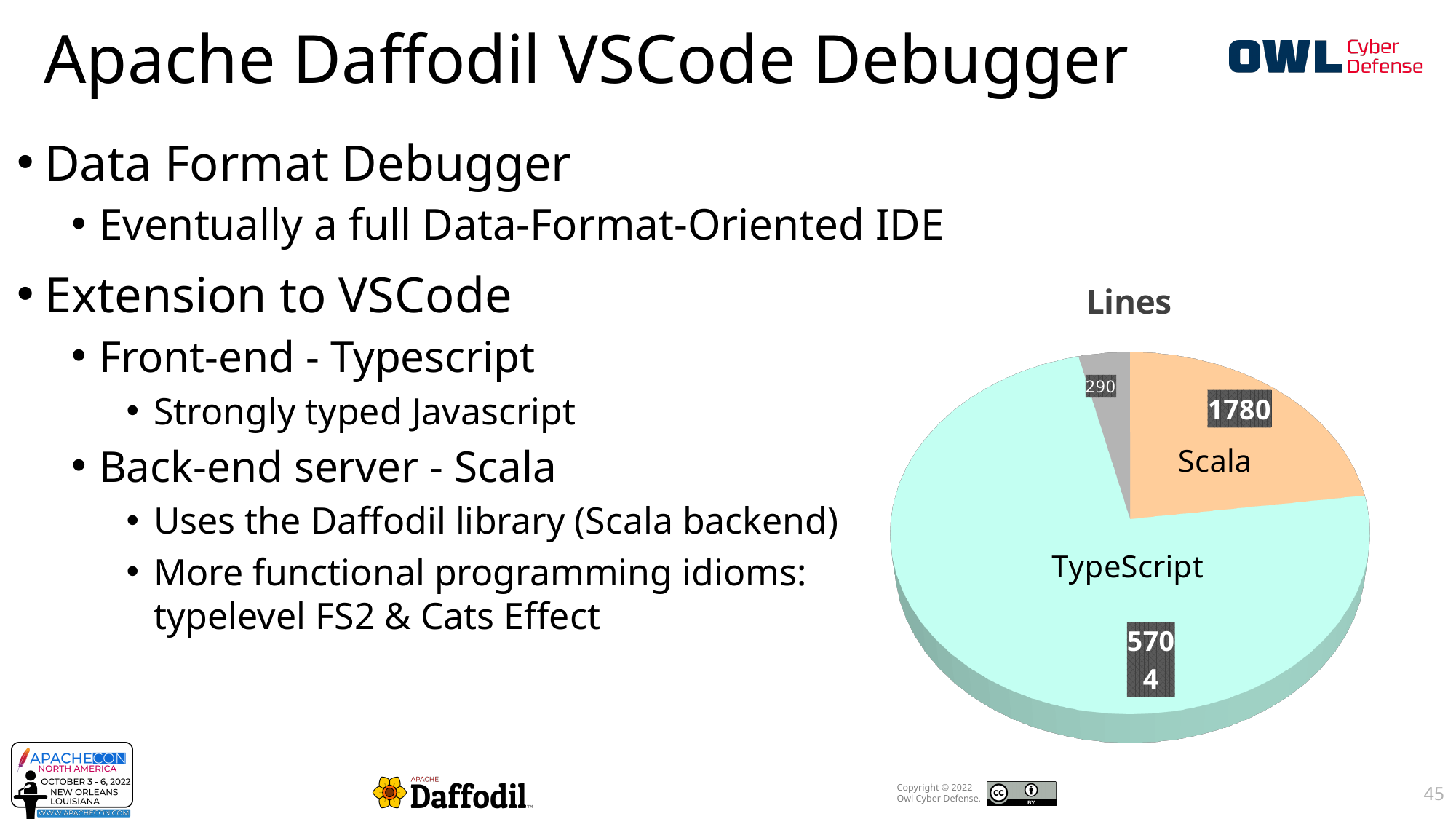
What is the difference between the TypeScript value and the Scala value? 3924 Which labelled category has the largest slice in the pie chart? TypeScript What is the value shown for TypeScript in the pie chart? 5704 What colour is the Scala slice in the pie chart? Orange What is the title of the chart? Lines Which is larger, the value for TypeScript or the value for Scala? TypeScript What is the total of all values shown in the pie chart? 7774 How many slices does the pie chart have? 3 What is the value printed on the smallest slice of the pie chart? 290 What type of chart is shown on the slide? Pie chart What is the value shown for Scala in the pie chart? 1780